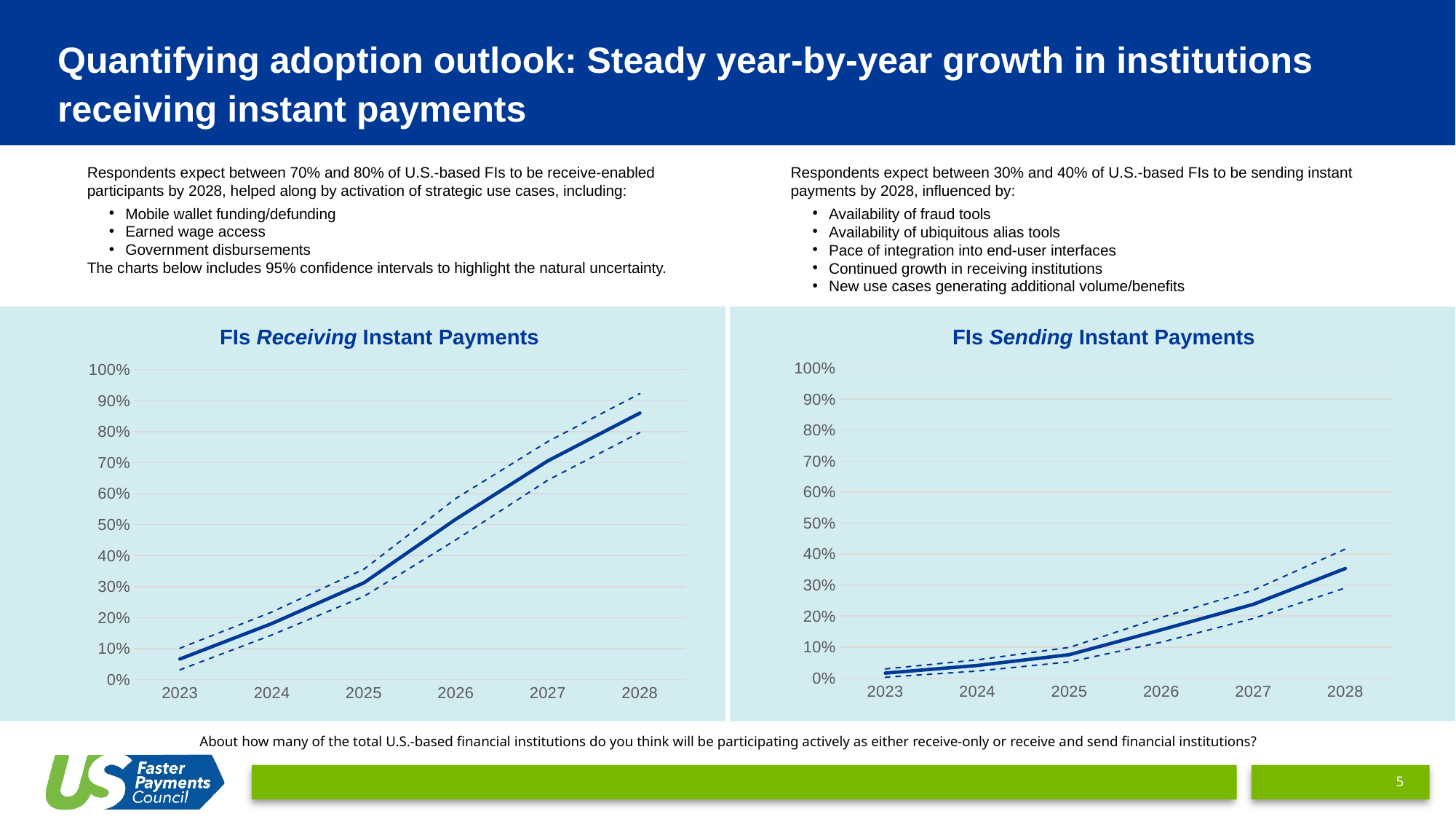
What do the dashed lines in the two charts represent? 95% confidence intervals In the 'FIs Receiving Instant Payments' chart, which year has the lowest value? 2023 In the 'FIs Receiving Instant Payments' chart, is the value for 2028 greater or less than 80%? greater In the 'FIs Sending Instant Payments' chart, which year has the highest value? 2028 What kind of chart is the 'FIs Receiving Instant Payments' chart? line chart In the 'FIs Sending Instant Payments' chart, is the value for 2025 greater or less than 10%? less Comparing the two charts, which is larger in 2028: the value for FIs receiving instant payments or the value for FIs sending instant payments? FIs receiving instant payments In the 'FIs Receiving Instant Payments' chart, is the value for 2025 greater or less than 40%? less In the 'FIs Receiving Instant Payments' chart, do the values rise or fall from 2023 to 2028? rise In the 'FIs Receiving Instant Payments' chart, how many years are shown on the x axis? 6